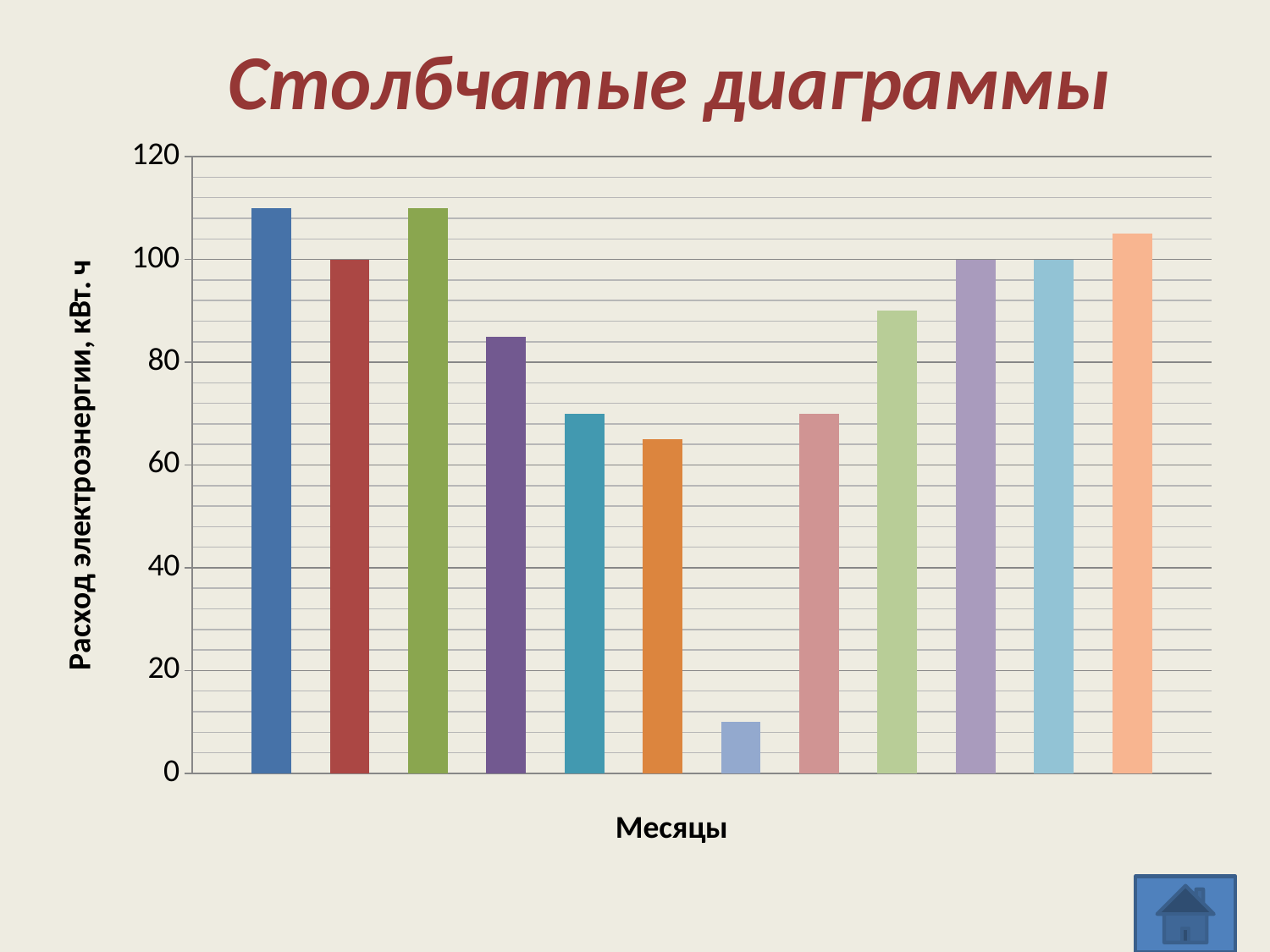
What kind of chart is shown on the slide? bar chart Is the value of the ninth bar from the left (the light green bar) greater or less than 100? less What is the value of the eleventh bar from the left (the light blue bar near the right)? 100 Which is larger, the first bar from the left or the second bar from the left? the first bar How many bars does the chart contain? 12 Is the value of the first bar from the left greater or less than 100? greater Is the value of the sixth bar from the left (the orange bar) greater or less than 60? greater What is the title of the vertical axis? Расход электроэнергии, кВт. ч Which bar is the lowest in the chart? the seventh bar from the left (the light blue bar) What is the value of the second bar from the left (the dark red bar)? 100 What is the title of the horizontal axis? Месяцы